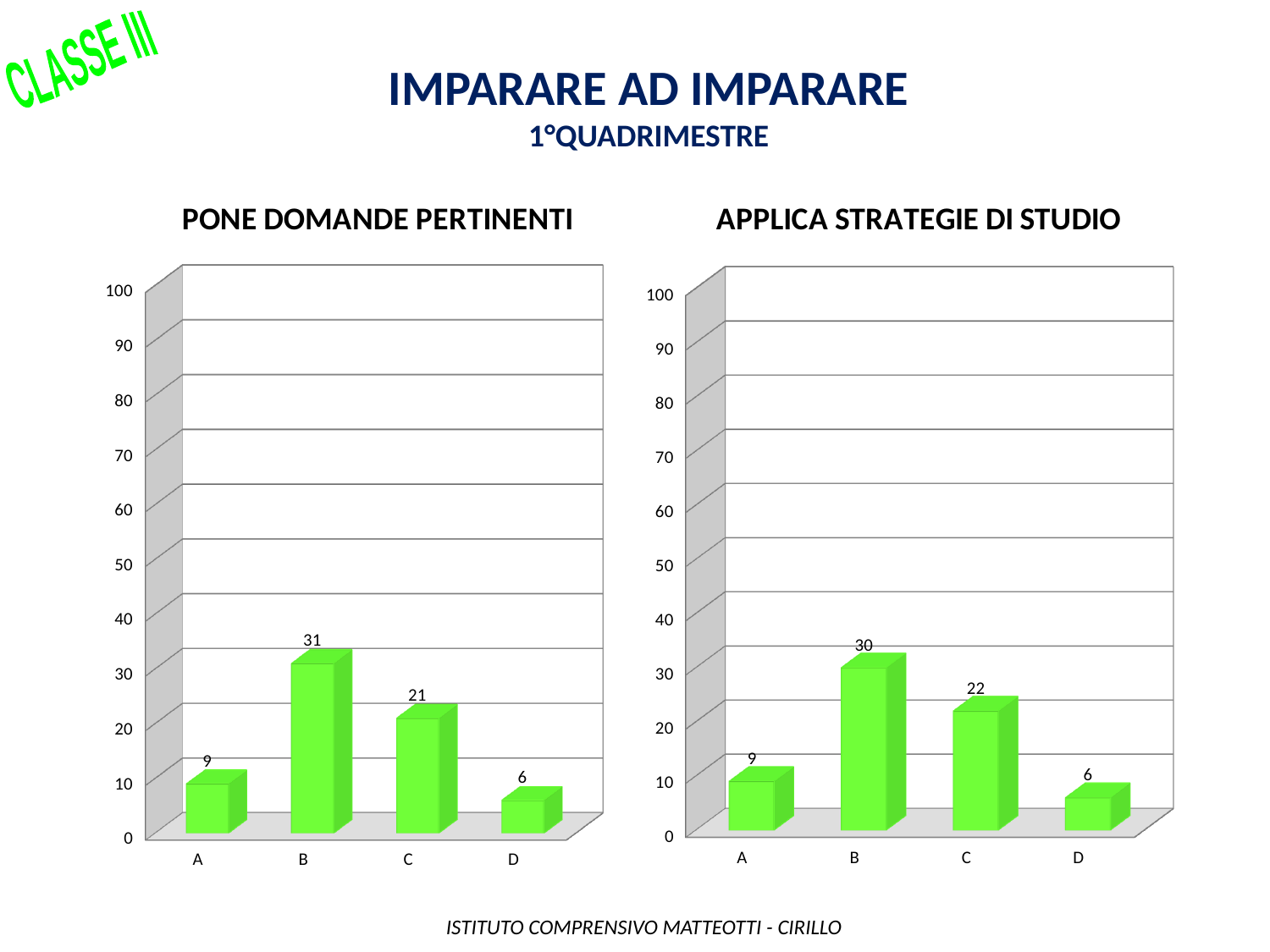
What kind of chart is the PONE DOMANDE PERTINENTI chart? bar chart In the APPLICA STRATEGIE DI STUDIO chart, what is the difference between the values for B and A? 21 In the PONE DOMANDE PERTINENTI chart, what is the value for category D? 6 In the PONE DOMANDE PERTINENTI chart, is the value for B greater or less than 30? greater In the PONE DOMANDE PERTINENTI chart, which category has the highest value? B In the APPLICA STRATEGIE DI STUDIO chart, which category has the lowest value? D In the PONE DOMANDE PERTINENTI chart, what is the value for category B? 31 In the PONE DOMANDE PERTINENTI chart, what is the difference between the values for B and C? 10 In the APPLICA STRATEGIE DI STUDIO chart, what is the value for category C? 22 How many categories are shown on the x axis of the APPLICA STRATEGIE DI STUDIO chart? 4 What is the title of the chart on the right side of the slide? APPLICA STRATEGIE DI STUDIO In the APPLICA STRATEGIE DI STUDIO chart, which is larger, the value for C or the value for D? C